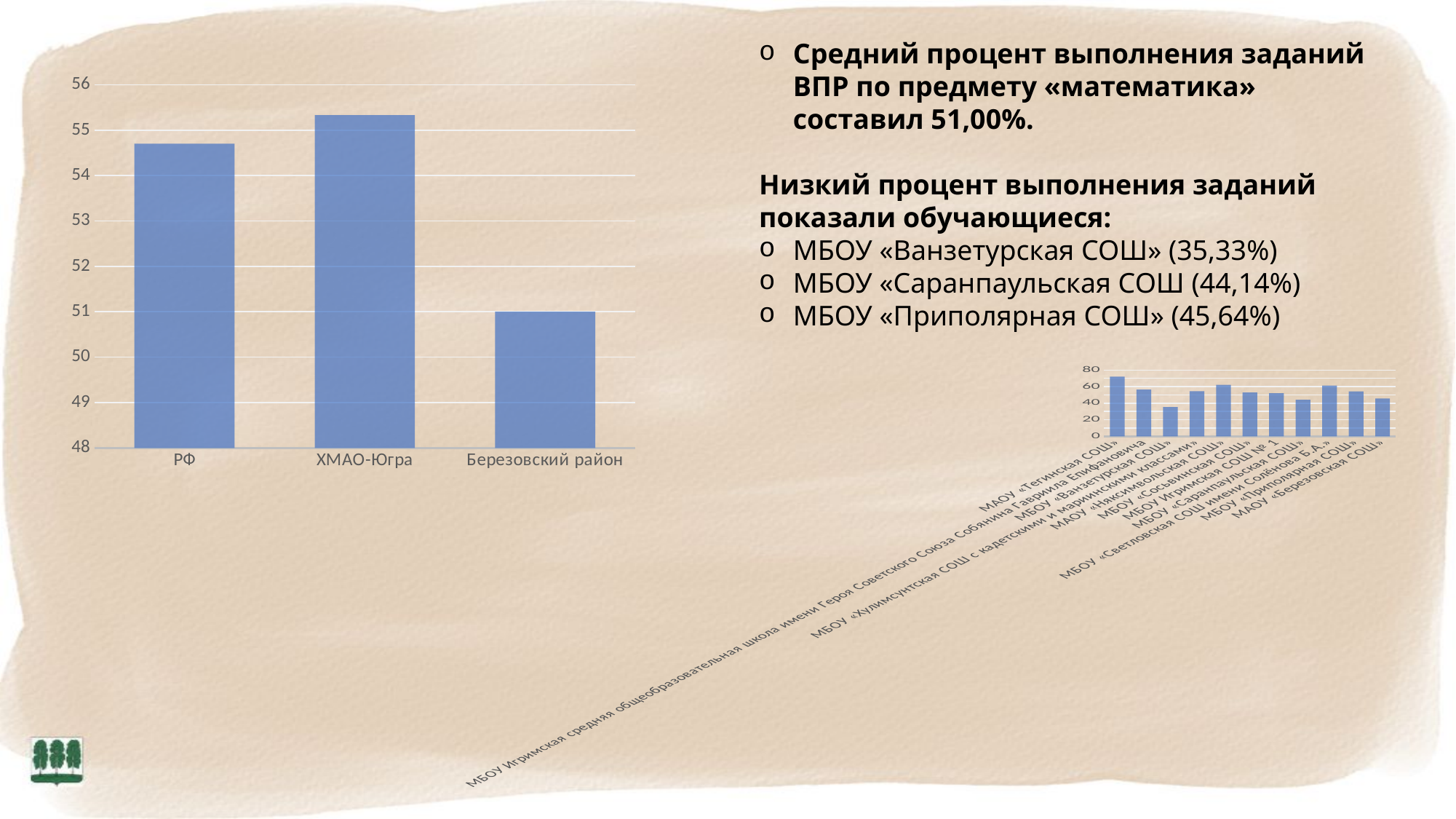
How many bars are shown in the small chart on the right of the slide? 11 How many categories are shown in the chart on the left of the slide? 3 In the chart on the left of the slide, which category has the lowest value? Березовский район In the chart on the left of the slide, what is the value for Березовский район? 51 In the chart on the left of the slide, which is larger: the value for РФ or the value for ХМАО-Югра? ХМАО-Югра In the small chart on the right of the slide, is the value for МБОУ «Ванзетурская СОШ» greater or less than 40? less In the chart on the left of the slide, which category has the highest value? ХМАО-Югра In the small chart on the right of the slide, which school has the highest value? МАОУ «Тегинская СОШ» In the chart on the left of the slide, is the value for Березовский район greater or less than 53? less What kind of chart is the chart on the left of the slide? bar chart In the small chart on the right of the slide, which school has the lowest value? МБОУ «Ванзетурская СОШ» In the chart on the left of the slide, is the value for РФ greater or less than 54? greater